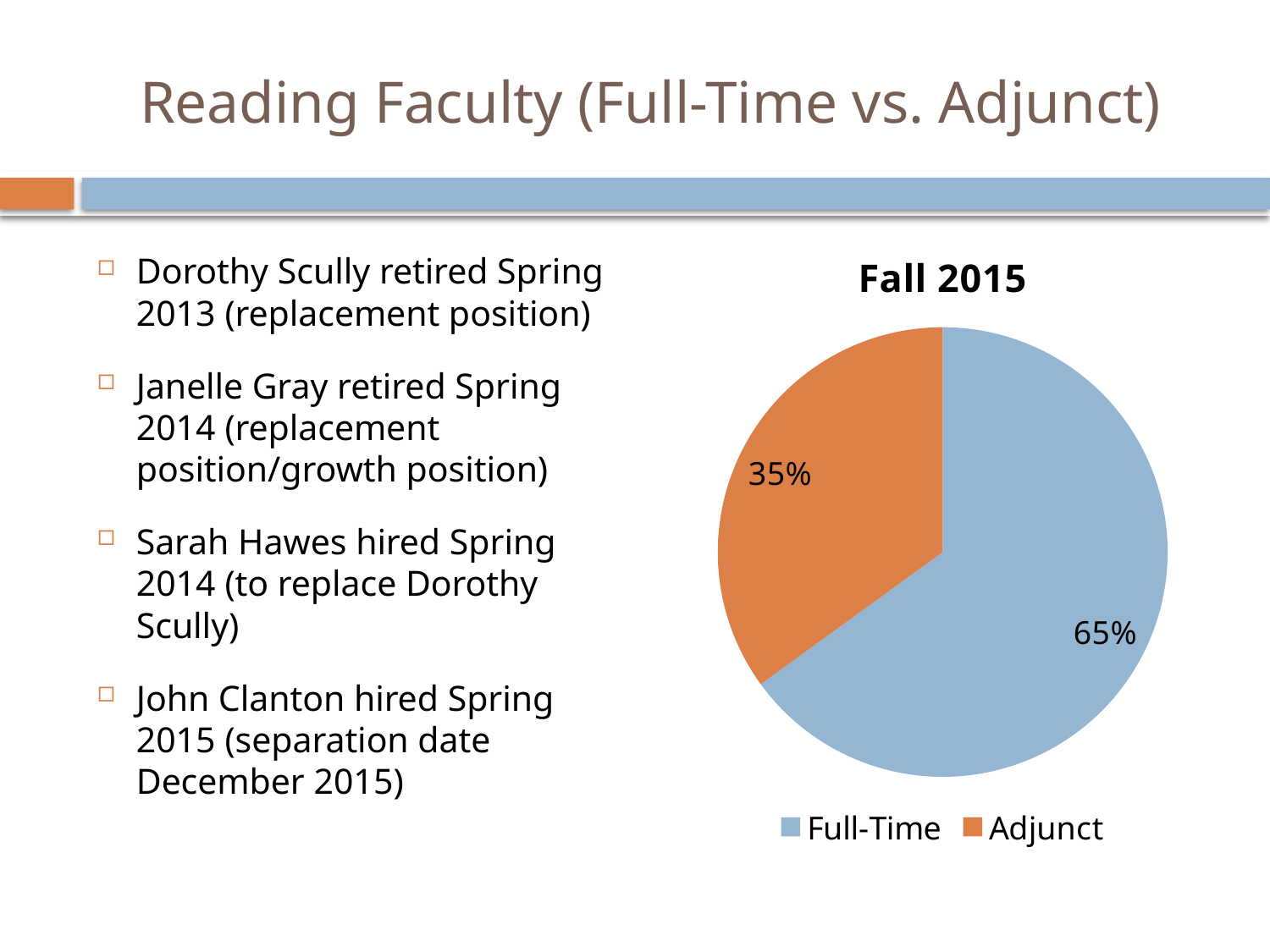
What is the difference in percentage points between the Full-Time and Adjunct slices? 30 What is the title of the chart? Fall 2015 What share of the pie does Adjunct represent? 35% What colour is the Adjunct slice? Orange What kind of chart is shown on the slide? Pie chart How many slices does the pie chart have? 2 Which slice of the pie is the largest? Full-Time How many entries does the legend list? 2 What share of the pie does Full-Time represent? 65% Which is larger, the Full-Time slice or the Adjunct slice? Full-Time Which slice of the pie is the smallest? Adjunct